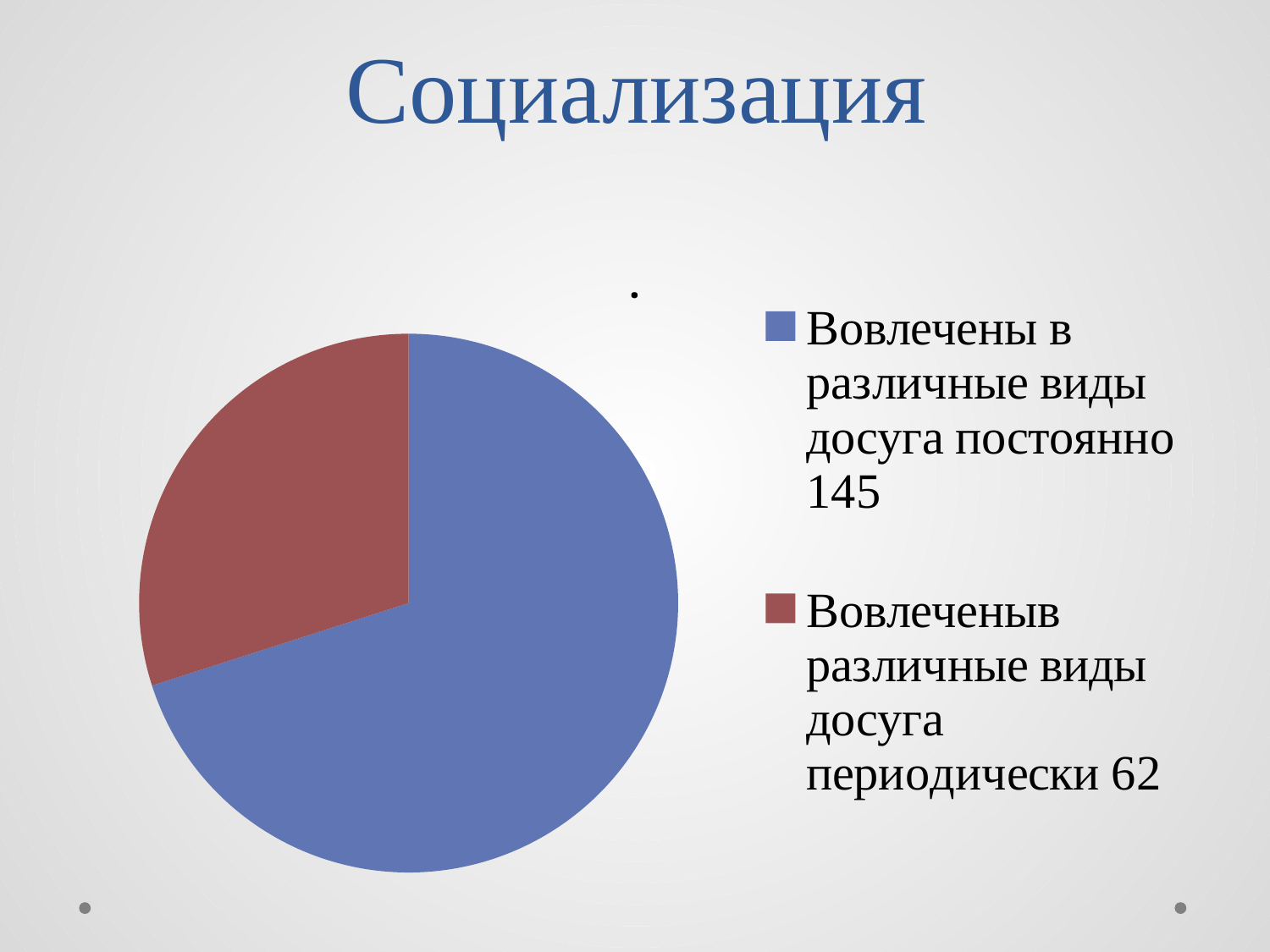
Which category has the largest slice of the pie? Вовлечены в различные виды досуга постоянно How many slices does the pie chart have? 2 Which category has the smallest slice of the pie? Вовлеченыв различные виды досуга периодически What is the value for "Вовлеченыв различные виды досуга периодически"? 62 What colour is the slice for "Вовлечены в различные виды досуга постоянно"? blue What is the title of the slide? Социализация What is the value for "Вовлечены в различные виды досуга постоянно"? 145 How many entries does the legend list? 2 What is the difference between the value for "постоянно" (145) and the value for "периодически" (62)? 83 What kind of chart is shown on the slide? pie chart What is the total of the two values shown in the legend? 207 Which is larger: the value for those involved in leisure constantly (постоянно) or periodically (периодически)? постоянно